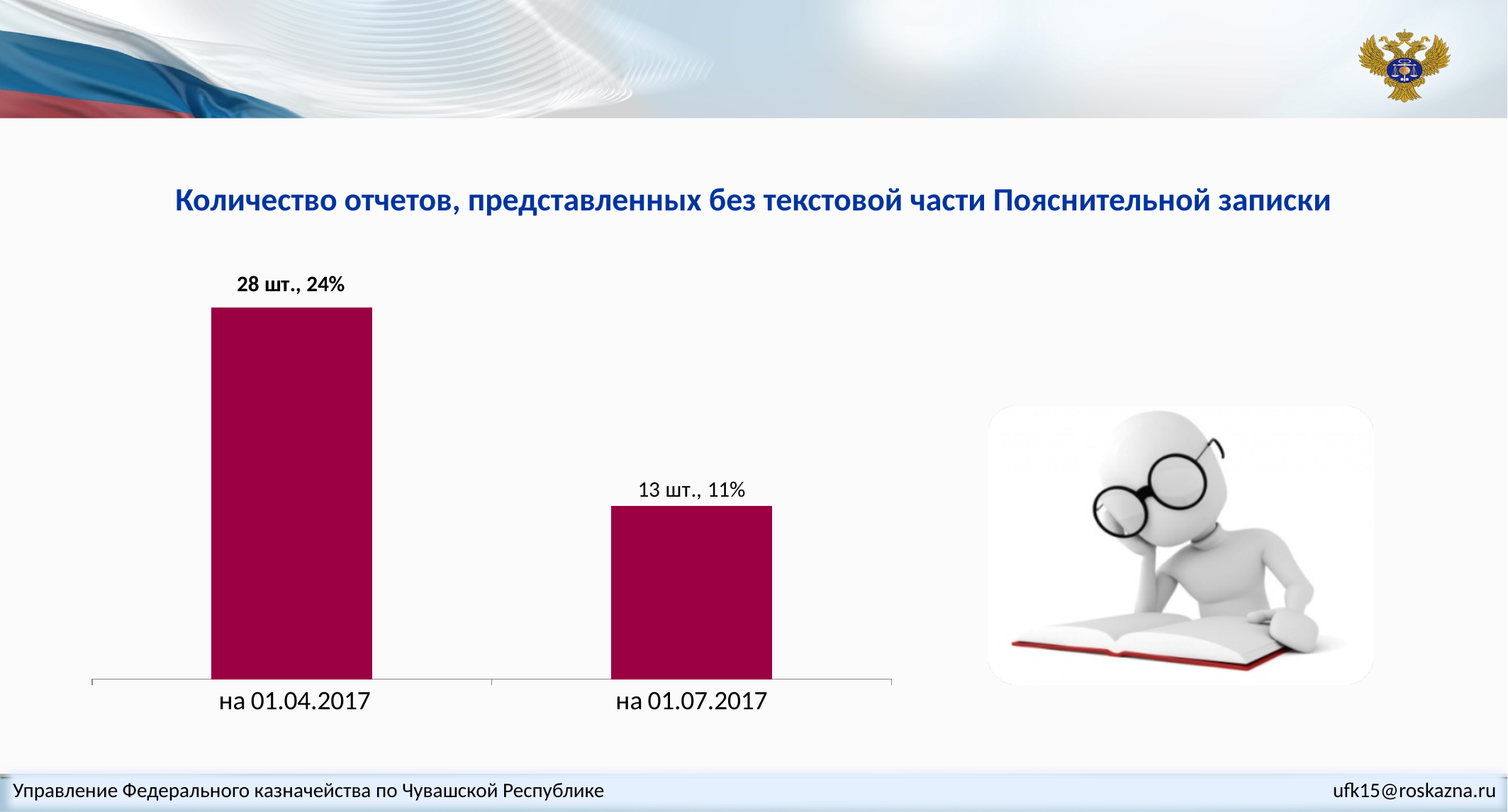
Do the values rise or fall from 'на 01.04.2017' to 'на 01.07.2017'? Fall What percentage is shown for 'на 01.04.2017'? 24% What kind of chart is shown on the slide? Bar chart What is the data label for the bar 'на 01.04.2017'? 28 шт., 24% How many categories are shown on the chart? 2 Which is larger: the value for 'на 01.04.2017' or for 'на 01.07.2017'? на 01.04.2017 How many reports (шт.) are shown for 'на 01.07.2017'? 13 шт. Which category has the highest value? на 01.04.2017 Which category has the lowest value? на 01.07.2017 What is the difference in the number of reports between 'на 01.04.2017' and 'на 01.07.2017'? 15 шт. What is the difference in percentage points between 'на 01.04.2017' and 'на 01.07.2017'? 13 What is the data label for the bar 'на 01.07.2017'? 13 шт., 11%